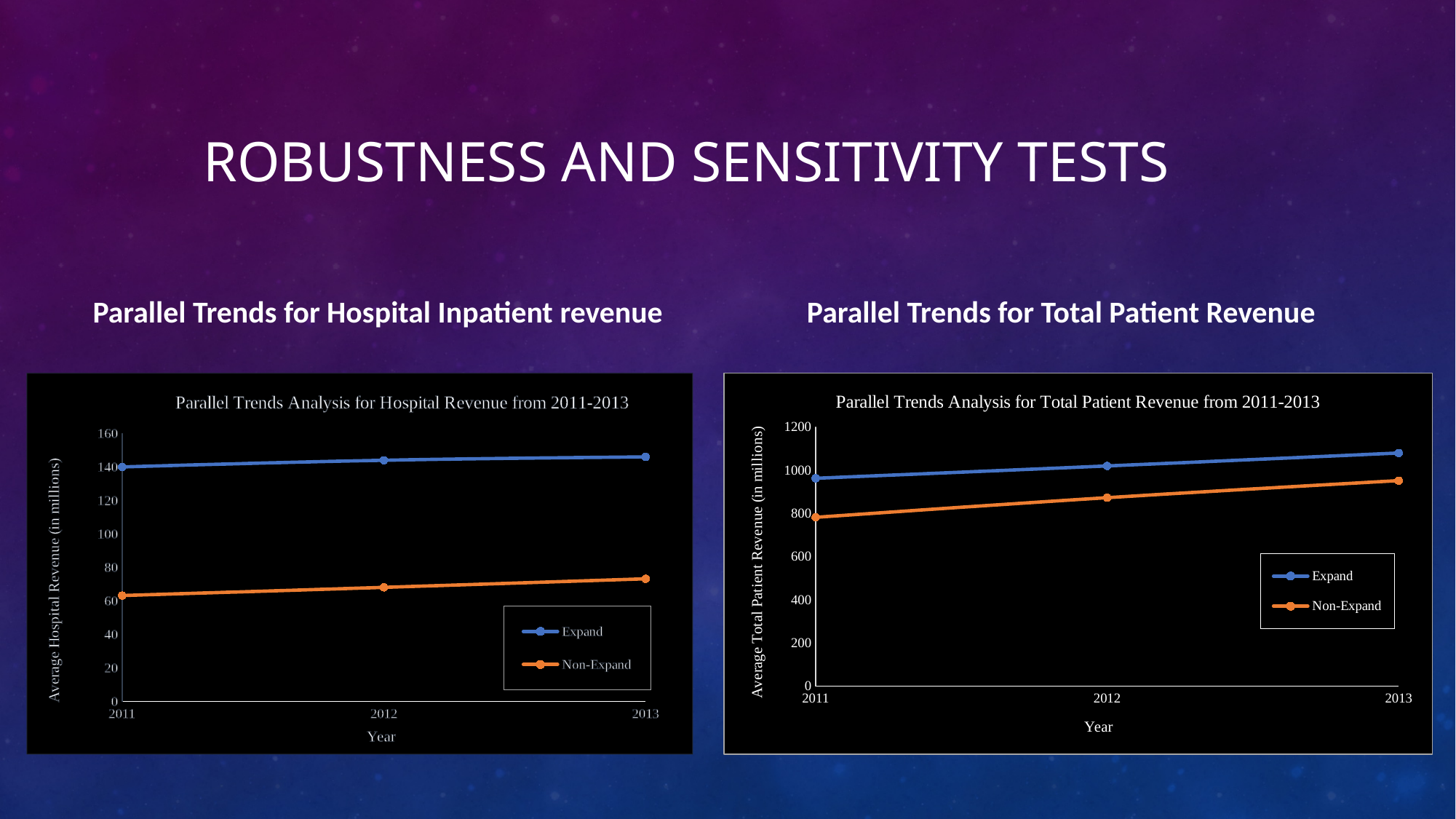
What is the y-axis label of the right chart, 'Parallel Trends Analysis for Total Patient Revenue from 2011-2013'? Average Total Patient Revenue (in millions) In the left chart, 'Parallel Trends Analysis for Hospital Revenue from 2011-2013', how many years are shown on the x axis? 3 In the left chart, 'Parallel Trends Analysis for Hospital Revenue from 2011-2013', which series has the higher values, Expand or Non-Expand? Expand How many series does the legend of the right chart, 'Parallel Trends Analysis for Total Patient Revenue from 2011-2013', list? 2 In the right chart, 'Parallel Trends Analysis for Total Patient Revenue from 2011-2013', is the Non-Expand value for 2011 greater or less than 600? greater In the right chart, 'Parallel Trends Analysis for Total Patient Revenue from 2011-2013', is the Expand value for 2013 greater or less than 1000? greater In the left chart, 'Parallel Trends Analysis for Hospital Revenue from 2011-2013', do the Expand values rise or fall from 2011 to 2013? rise In the left chart, 'Parallel Trends Analysis for Hospital Revenue from 2011-2013', is the Expand value for 2011 greater or less than 120? greater In the right chart, 'Parallel Trends Analysis for Total Patient Revenue from 2011-2013', do the Non-Expand values rise or fall from 2011 to 2013? rise In the left chart, 'Parallel Trends Analysis for Hospital Revenue from 2011-2013', what colour is the Non-Expand line? orange What type of chart is the left chart, 'Parallel Trends Analysis for Hospital Revenue from 2011-2013'? line chart